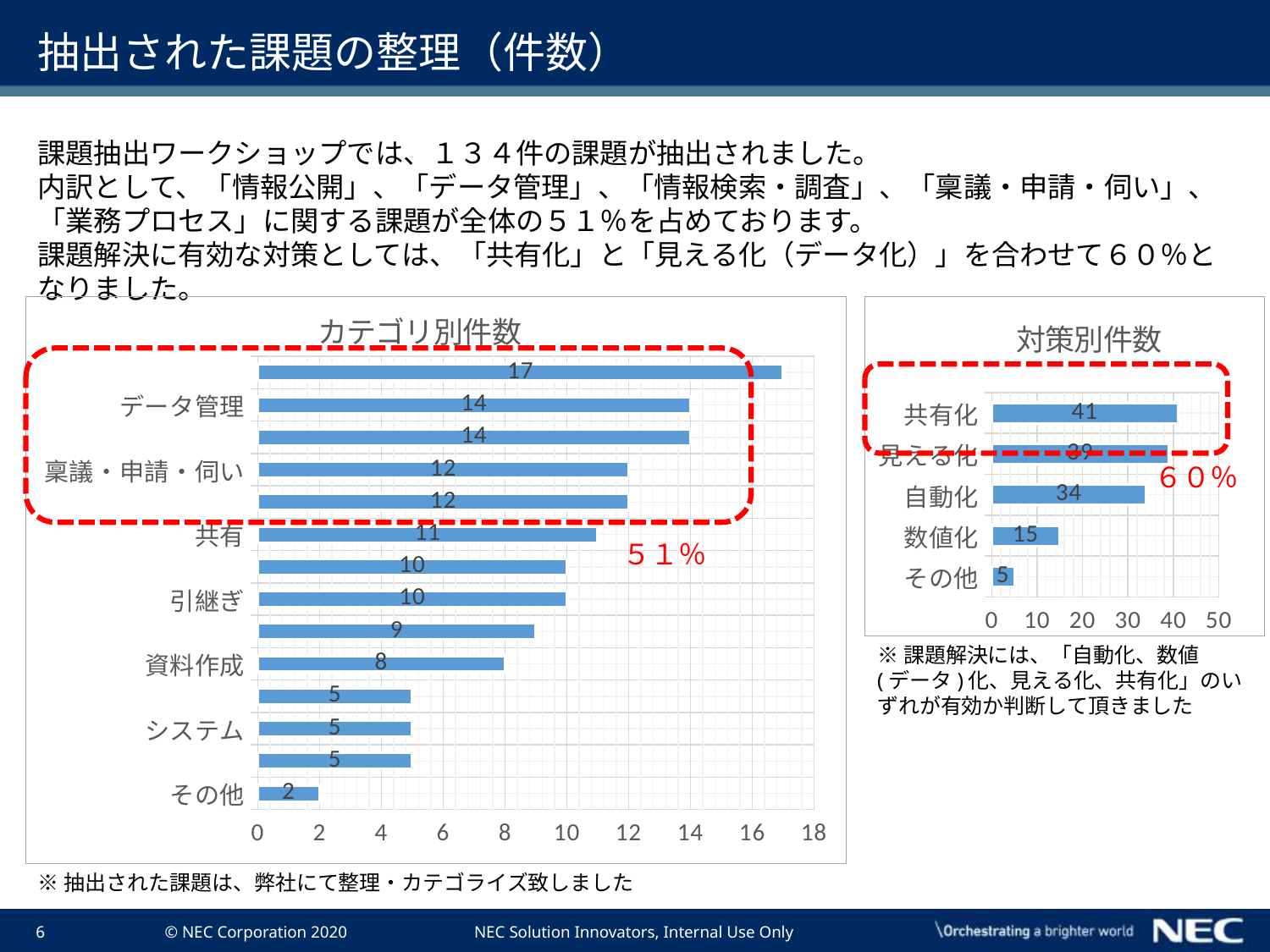
In the 対策別件数 chart, what is the value for 自動化? 34 How many categories are shown in the 対策別件数 chart? 5 In the 対策別件数 chart, what is the difference between the values for 共有化 and 自動化? 7 What kind of chart is the カテゴリ別件数 chart? bar chart In the カテゴリ別件数 chart, which is larger, the value for 共有 or the value for 引継ぎ? 共有 In the カテゴリ別件数 chart, which category has the lowest value? その他 In the カテゴリ別件数 chart, what is the value for 稟議・申請・伺い? 12 In the 対策別件数 chart, which category has the highest value? 共有化 In the 対策別件数 chart, what is the value for 共有化? 41 In the 対策別件数 chart, is the value for 見える化 greater or less than 30? greater In the カテゴリ別件数 chart, what is the value for データ管理? 14 In the 対策別件数 chart, which category has the lowest value? その他